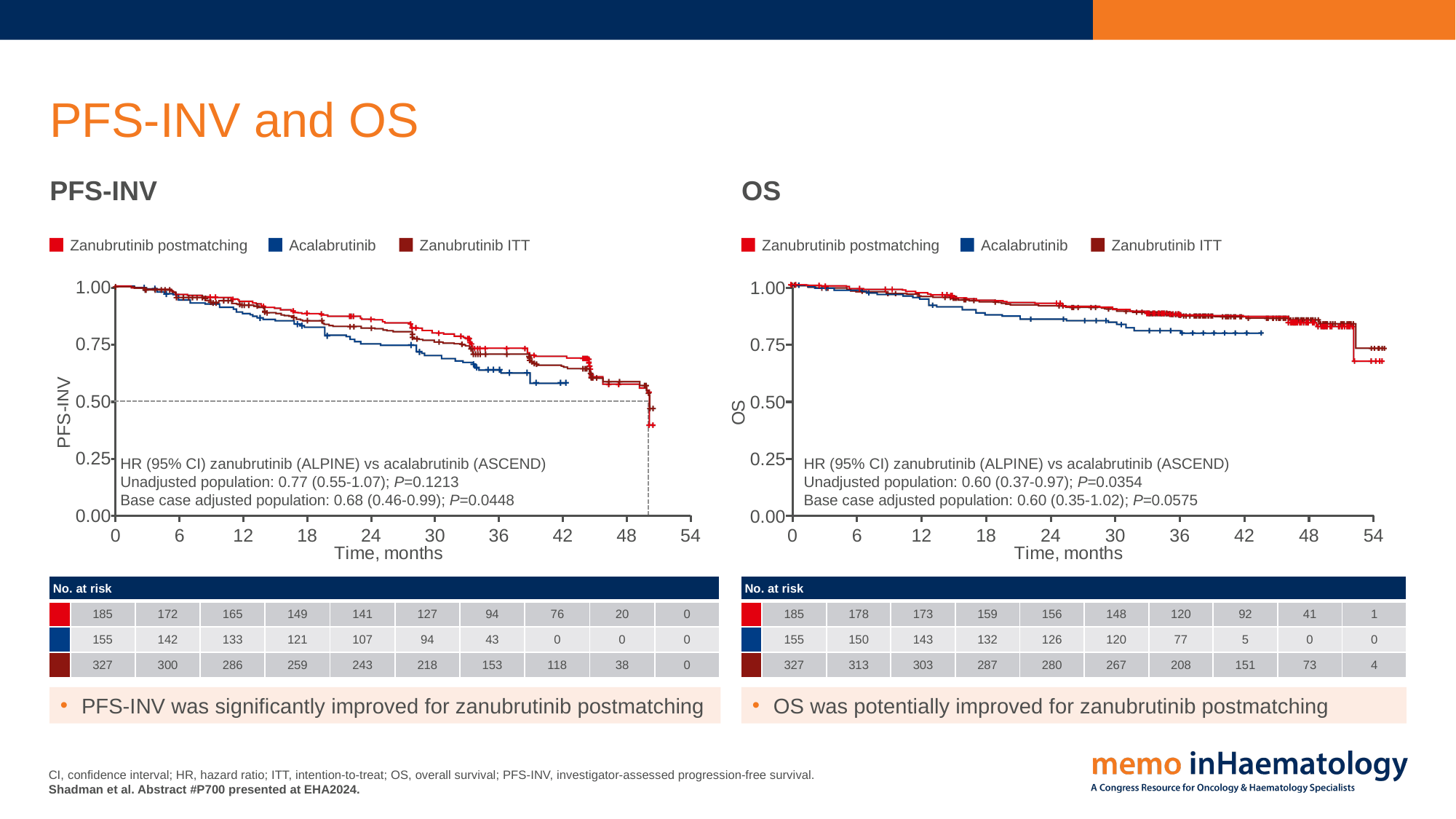
How many series does the legend of the OS chart list? 3 What is the x-axis label of the OS chart? Time, months In the PFS-INV chart, what is the base case adjusted population hazard ratio (95% CI) shown? 0.68 (0.46-0.99) In the OS chart, is the Acalabrutinib curve at 42 months greater or less than 0.75? greater In the OS chart, is the Zanubrutinib postmatching curve at 54 months greater or less than 0.75? less In the PFS-INV chart's number-at-risk table, how many Acalabrutinib patients were at risk at 36 months? 43 What kind of chart is the PFS-INV chart? Line chart (Kaplan-Meier survival curve) In the PFS-INV chart, is the Acalabrutinib curve at 36 months greater or less than 0.50? greater In the OS chart's number-at-risk table, how many Zanubrutinib postmatching patients were at risk at 48 months? 41 In the PFS-INV chart, do the curves rise or fall as time increases along the x axis? Fall In the PFS-INV chart's number-at-risk table, what is the difference between the Zanubrutinib ITT and Zanubrutinib postmatching numbers at risk at 0 months? 142 In the OS chart's number-at-risk table, which has more patients at risk at 24 months: Zanubrutinib postmatching or Acalabrutinib? Zanubrutinib postmatching